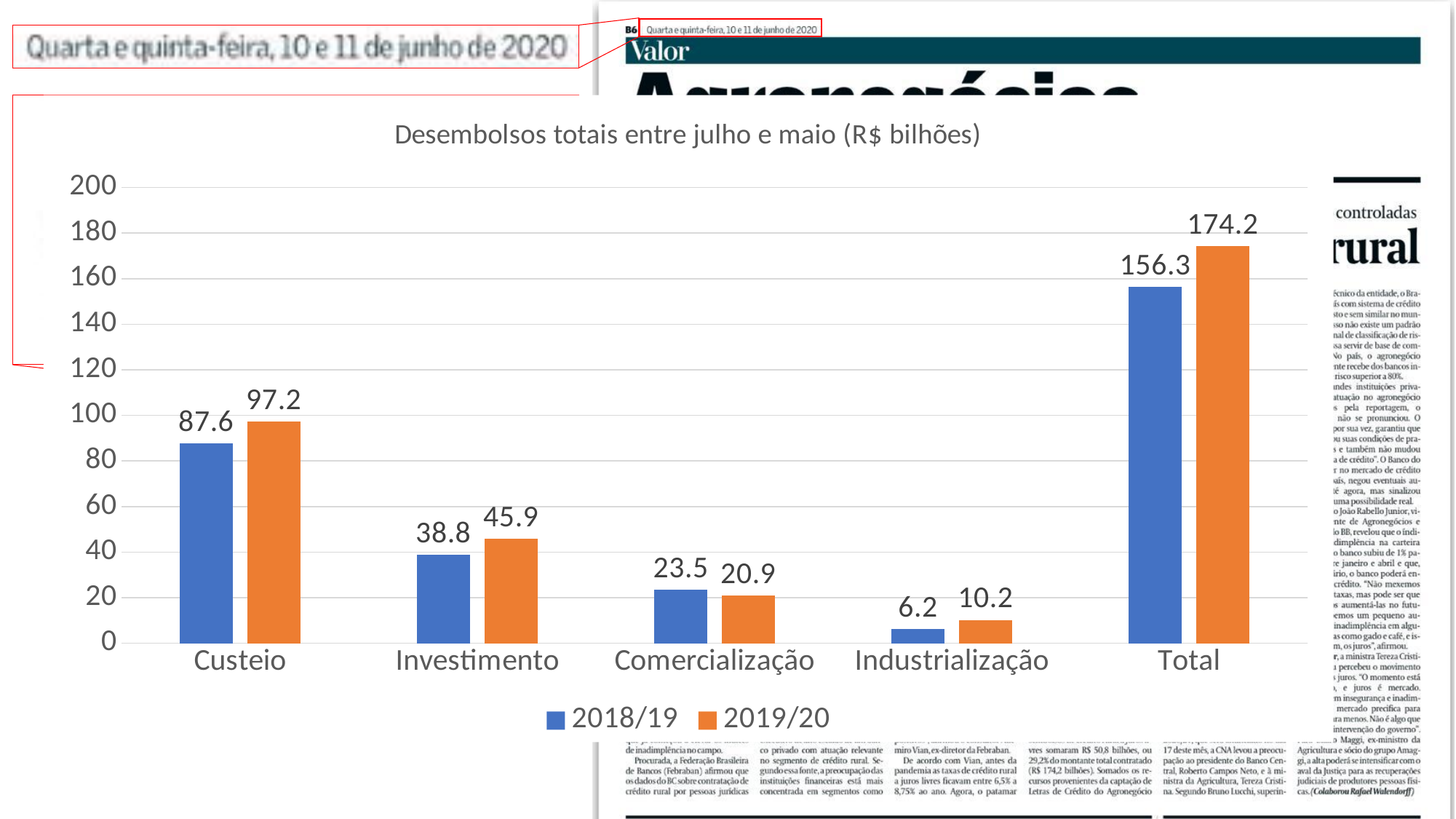
Which category has the lowest value in the 2018/19 series? Industrialização What is the title of the chart? Desembolsos totais entre julho e maio (R$ bilhões) What kind of chart is shown? bar chart Is the 2018/19 value for Custeio greater or less than 80? greater What is the difference between the 2019/20 and 2018/19 values for Total? 17.9 Which category has the highest value in the 2019/20 series? Total How many series does the legend list? 2 What is the value for Industrialização in the 2019/20 series? 10.2 What is the value for Investimento in the 2018/19 series? 38.8 What is the value for Custeio in the 2019/20 series? 97.2 Which is larger for Comercialização: the 2018/19 value or the 2019/20 value? 2018/19 How many categories are shown on the x axis? 5